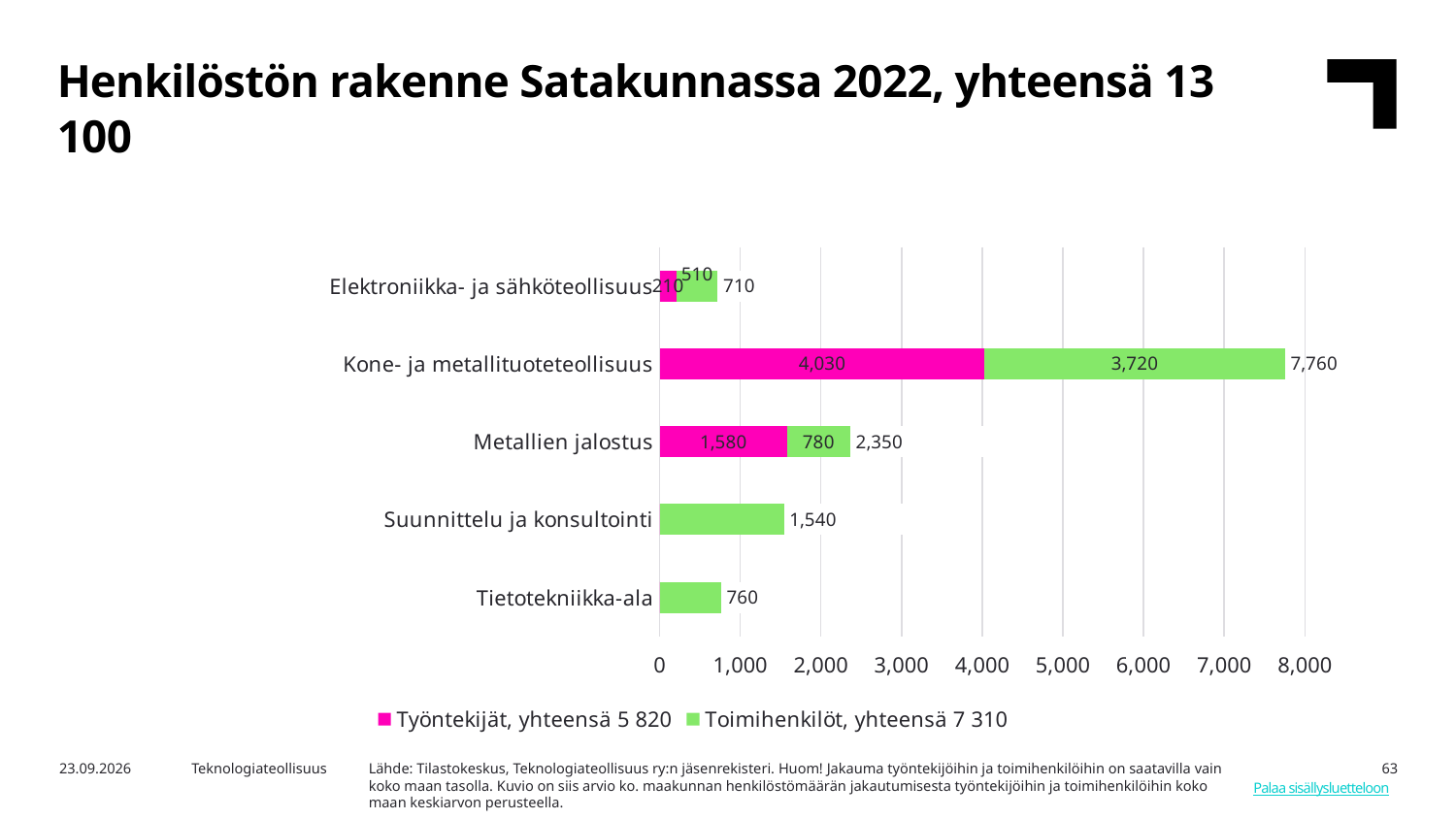
What is the difference between the Työntekijät and Toimihenkilöt values for Metallien jalostus? 800 What is the total shown for Suunnittelu ja konsultointi? 1,540 What is the Työntekijät value for Kone- ja metallituoteteollisuus? 4,030 Which category has the lowest total? Elektroniikka- ja sähköteollisuus How many series does the legend list? 2 Which category has the highest total? Kone- ja metallituoteteollisuus What is the Toimihenkilöt value for Metallien jalostus? 780 Which is larger for Kone- ja metallituoteteollisuus: the Työntekijät value or the Toimihenkilöt value? Työntekijät What is the total of the stacked bar for Elektroniikka- ja sähköteollisuus? 710 How many categories are shown on the chart? 5 What total is given for Toimihenkilöt in the legend? 7 310 What type of chart is shown on the slide? Stacked bar chart